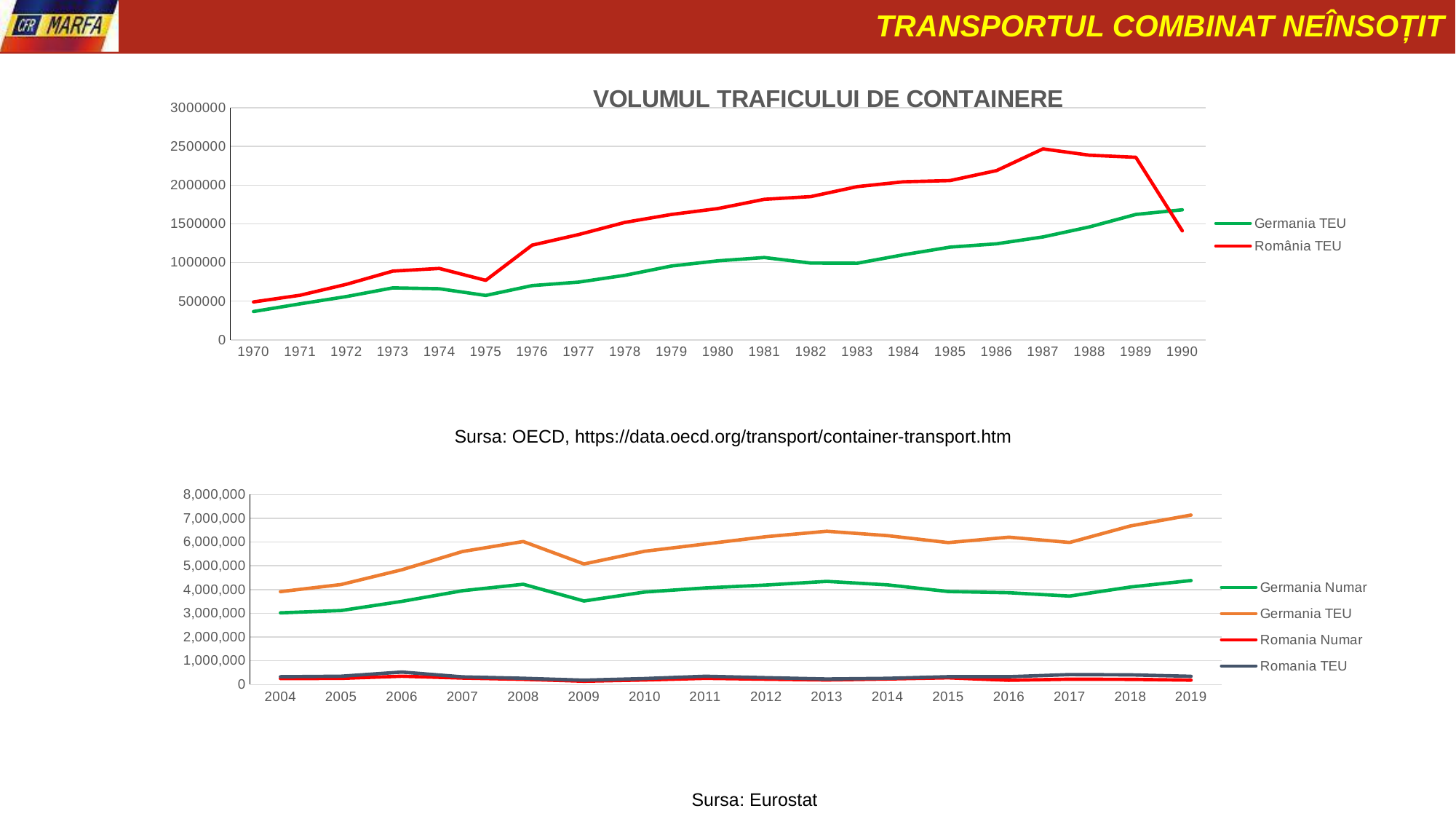
In the top chart 'VOLUMUL TRAFICULUI DE CONTAINERE', which series has the larger value in 1990, Germania TEU or România TEU? Germania TEU In the top chart 'VOLUMUL TRAFICULUI DE CONTAINERE', in which year does România TEU reach its highest value? 1987 In the top chart 'VOLUMUL TRAFICULUI DE CONTAINERE', in which year is Germania TEU at its lowest? 1970 In the top chart 'VOLUMUL TRAFICULUI DE CONTAINERE', is the România TEU value for 1987 greater or less than 2000000? greater In the bottom chart (2004–2019), is the Germania TEU value for 2019 greater or less than 6,000,000? greater In the top chart 'VOLUMUL TRAFICULUI DE CONTAINERE', does Germania TEU generally rise or fall from 1970 to 1990? Rise In the top chart 'VOLUMUL TRAFICULUI DE CONTAINERE', how many series does the legend list? 2 In the top chart 'VOLUMUL TRAFICULUI DE CONTAINERE', how many years are shown on the x axis? 21 In the bottom chart (2004–2019), how many series does the legend list? 4 In the bottom chart (2004–2019), how many years are shown on the x axis? 16 What type of chart is the top chart titled 'VOLUMUL TRAFICULUI DE CONTAINERE'? Line chart In the bottom chart (2004–2019), which series has the highest values throughout the period? Germania TEU